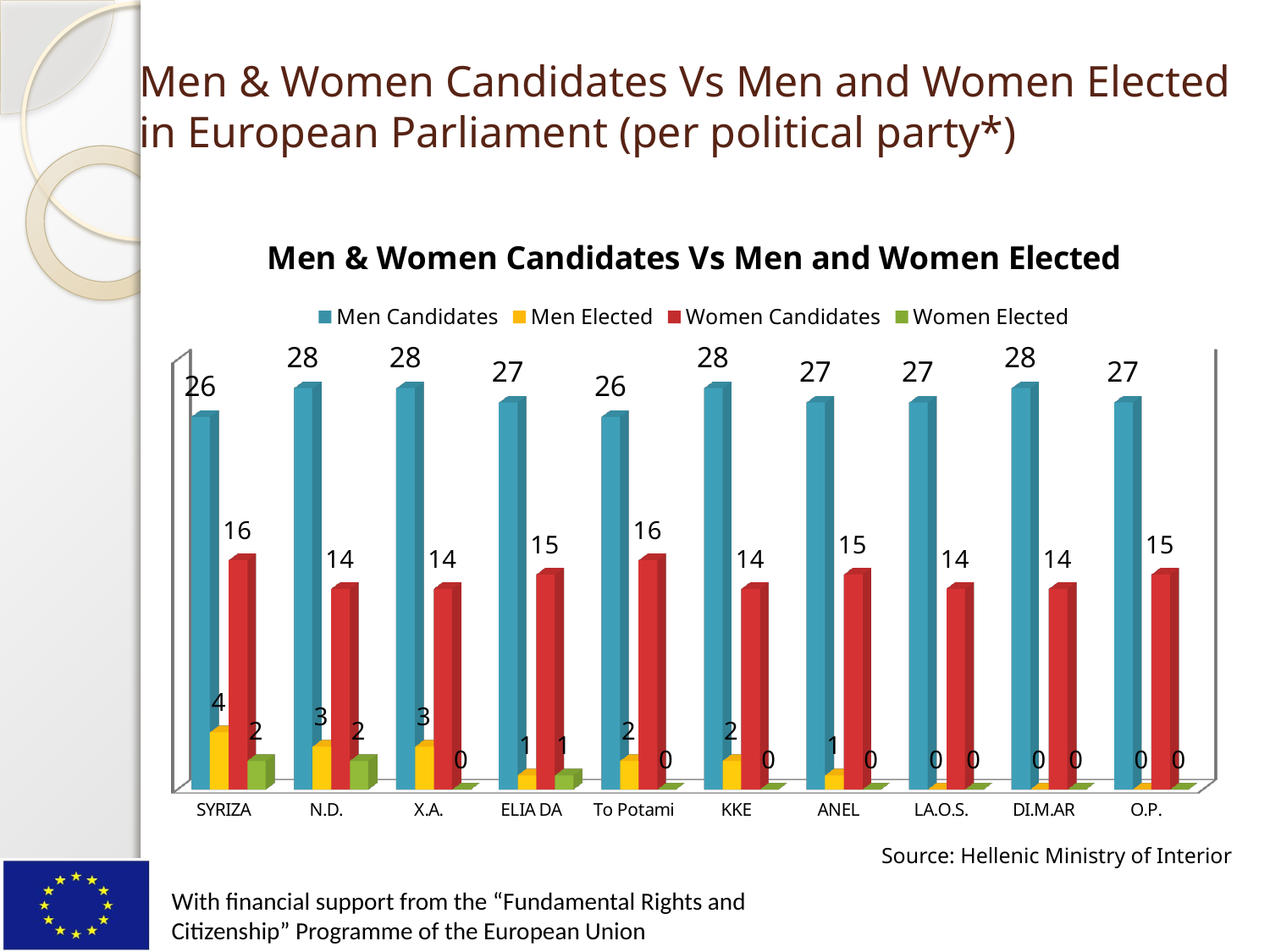
What is the value of Women Candidates for To Potami? 16 What is the value of Men Candidates for SYRIZA? 26 What is the difference between Men Elected for SYRIZA and Men Elected for ANEL? 3 What is the value of Women Elected for ELIA DA? 1 What type of chart is shown on the slide? Bar chart Which party has the highest value for Men Elected? SYRIZA What is the difference between Men Candidates and Women Candidates for KKE? 14 What is the value of Men Elected for N.D.? 3 How many series does the chart legend list? 4 Which series in the legend is shown in red? Women Candidates Which is larger for X.A.: Men Candidates or Women Candidates? Men Candidates How many political parties are shown on the x axis of the chart? 10